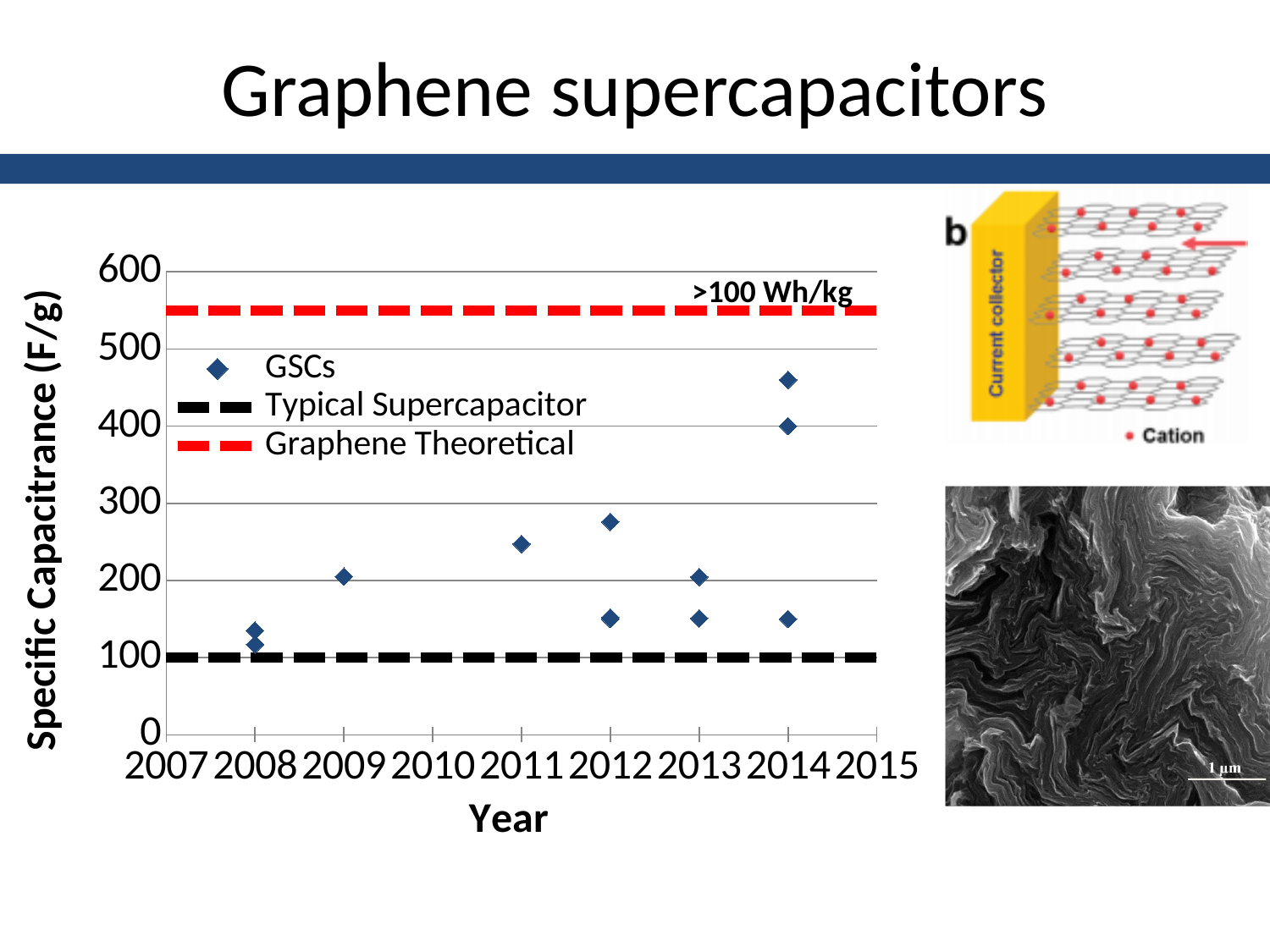
What kind of chart is shown on the slide? scatter chart Is the Graphene Theoretical line greater or less than 500? greater What are the three series listed in the chart legend? GSCs, Typical Supercapacitor, Graphene Theoretical Is the highest GSCs value in 2014 greater or less than 400? greater How many GSCs data points are plotted for 2014? 3 Is the highest GSCs value in 2012 greater or less than 300? less Which is larger, the highest GSCs value in 2012 or the highest GSCs value in 2013? 2012 How many series does the chart legend list? 3 What is the y-axis title of the chart? Specific Capacitrance (F/g) In which year does the highest GSCs data point appear? 2014 At what value on the y-axis does the Typical Supercapacitor line sit? 100